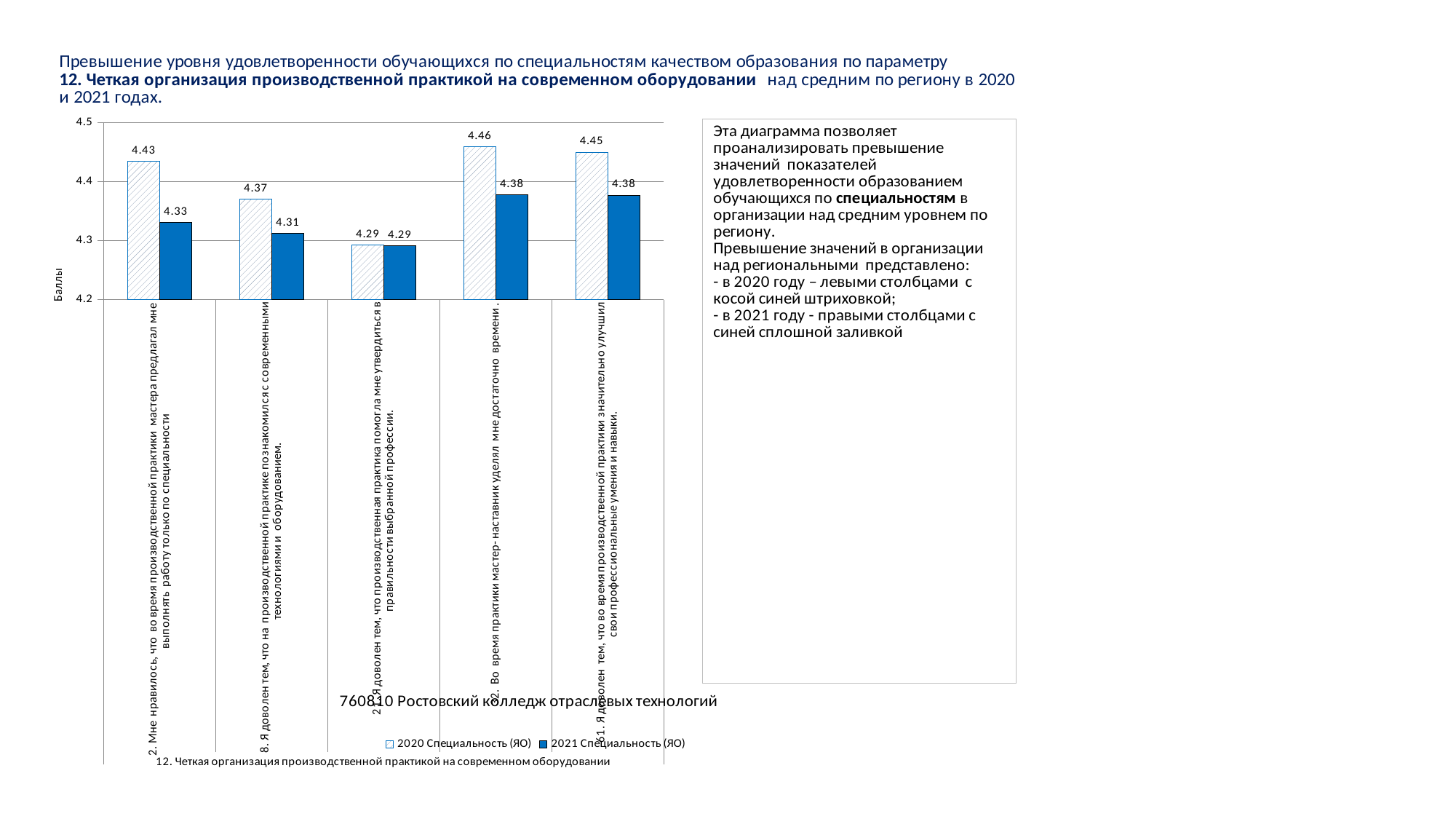
Is the 2021 Специальность (ЯО) value for statement 2 greater or less than 4.3? greater What is the 2021 Специальность (ЯО) value for statement 8 ("Я доволен тем, что на производственной практике познакомился с современными технологиями и оборудованием")? 4.31 What is the difference between the 2020 and 2021 values for statement 2? 0.10 Which statement has the highest 2020 Специальность (ЯО) value? 32. Во время практики мастер-наставник уделял мне достаточно времени What is the 2020 Специальность (ЯО) value for statement 2 ("Мне нравилось, что во время производственной практики мастер предлагал мне выполнять работу только по специальности")? 4.43 What type of chart is shown on the slide? bar chart How many series does the legend list? 2 How many categories (statements) are plotted on the x axis? 5 What is the 2021 Специальность (ЯО) value for statement 32 ("Во время практики мастер-наставник уделял мне достаточно времени")? 4.38 What is the label of the y axis? Баллы Which statement has the lowest 2021 Специальность (ЯО) value? 21. Я доволен тем, что производственная практика помогла мне утвердиться в правильности выбранной профессии